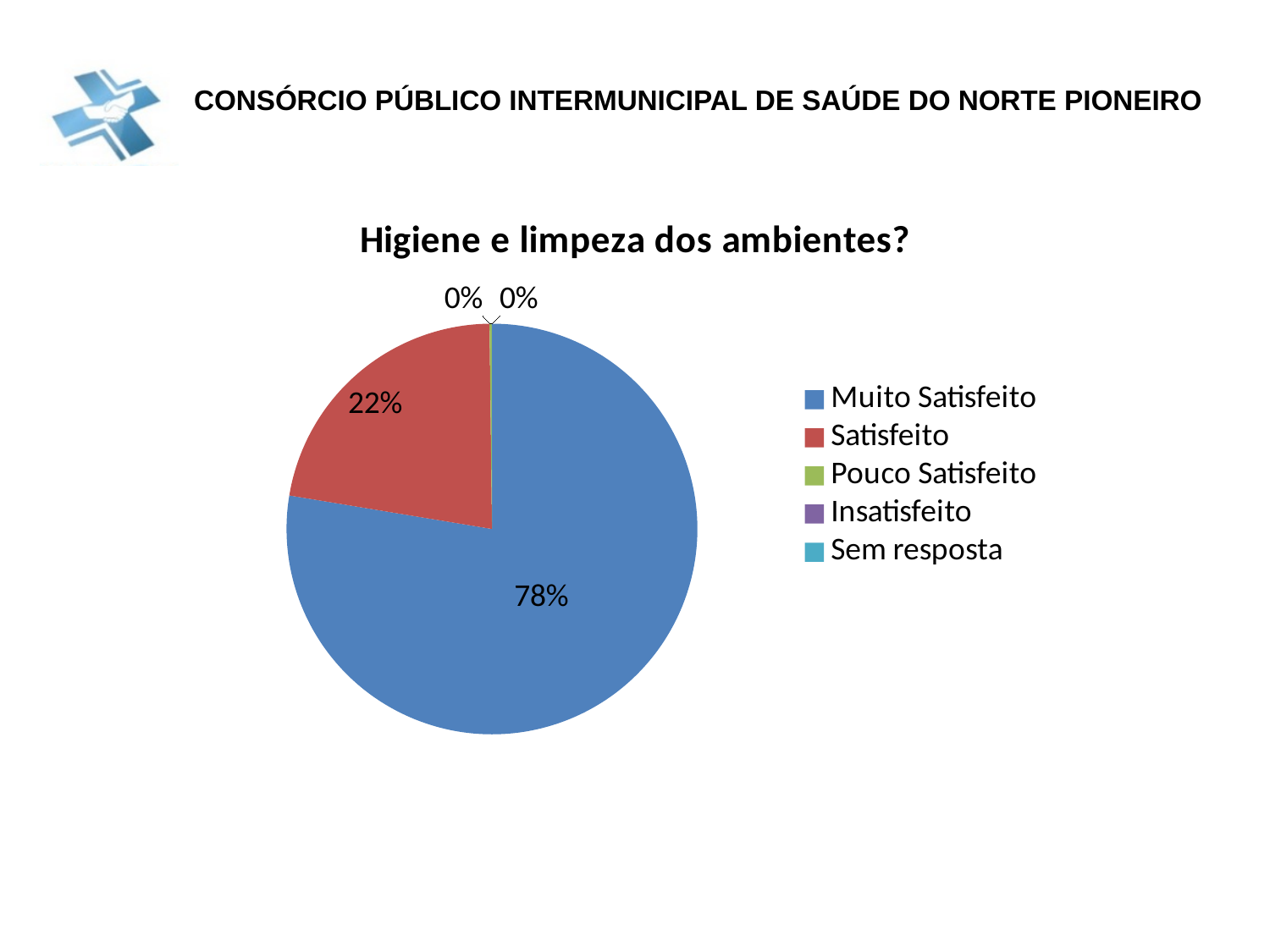
Is the value for Muito Satisfeito greater or less than 50%? greater How many categories does the legend list? 5 What is the difference between the Muito Satisfeito and Satisfeito percentages? 56 percentage points What is the value shown for Satisfeito? 22% What kind of chart is shown on the slide? Pie chart What share of the pie does Muito Satisfeito represent? 78% What is the title of the chart? Higiene e limpeza dos ambientes? Which category has the largest slice of the pie? Muito Satisfeito Which is larger, Muito Satisfeito or Satisfeito? Muito Satisfeito What is the combined total of the Muito Satisfeito and Satisfeito slices? 100% What colour is the Satisfeito slice? Red